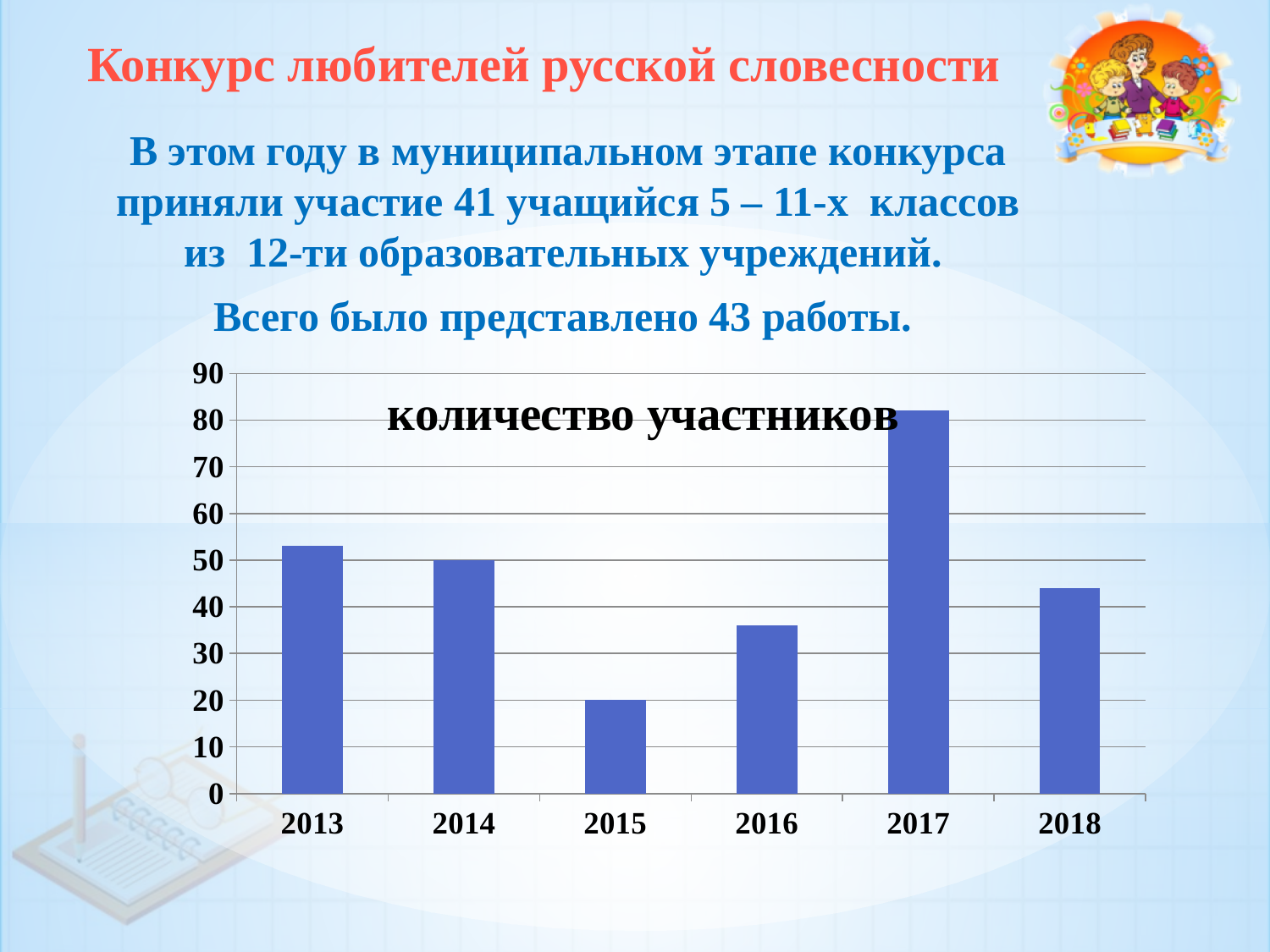
Is the value for 2016 greater or less than 40? less What is the number of participants in 2015? 20 What is the number of participants in 2014? 50 How many years are shown on the x axis of the chart? 6 What kind of chart is shown on the slide? bar chart Which year has the lowest number of participants? 2015 Do the values rise or fall from 2013 to 2015? fall Is the value for 2017 greater or less than 70? greater Which year has the highest number of participants? 2017 Is the value for 2013 greater or less than 60? less What is the title of the chart? количество участников Which year has more participants, 2013 or 2016? 2013